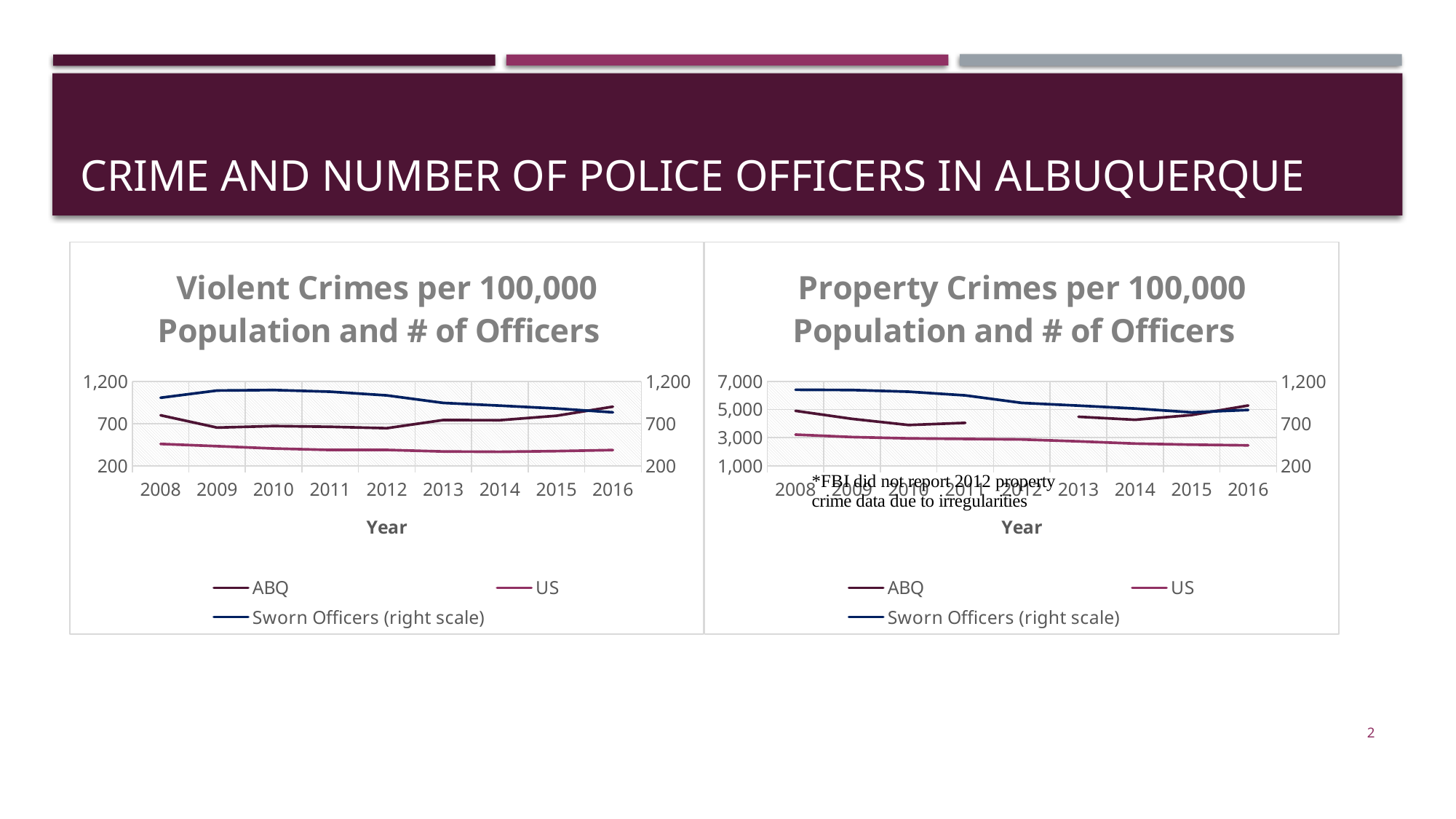
In the 'Violent Crimes per 100,000 Population and # of Officers' chart, which is larger in 2016, the ABQ value or the US value? ABQ Which series in the 'Property Crimes per 100,000 Population and # of Officers' chart is plotted on the right scale? Sworn Officers What kind of chart is the 'Violent Crimes per 100,000 Population and # of Officers' chart? line chart In the 'Violent Crimes per 100,000 Population and # of Officers' chart, is the ABQ value for 2008 greater or less than 700? greater What is the x-axis title of the 'Violent Crimes per 100,000 Population and # of Officers' chart? Year How many series does the legend of the 'Property Crimes per 100,000 Population and # of Officers' chart list? 3 In the 'Violent Crimes per 100,000 Population and # of Officers' chart, is the US value for 2016 greater or less than 700? less How many years are shown on the x axis of the 'Violent Crimes per 100,000 Population and # of Officers' chart? 9 In the 'Property Crimes per 100,000 Population and # of Officers' chart, which is larger in 2008, the ABQ value or the US value? ABQ In the 'Property Crimes per 100,000 Population and # of Officers' chart, does the US line rise or fall from 2008 to 2016? fall In the 'Violent Crimes per 100,000 Population and # of Officers' chart, does the US line rise or fall from 2008 to 2016? fall In the 'Property Crimes per 100,000 Population and # of Officers' chart, is the US value for 2016 greater or less than 3,000? less